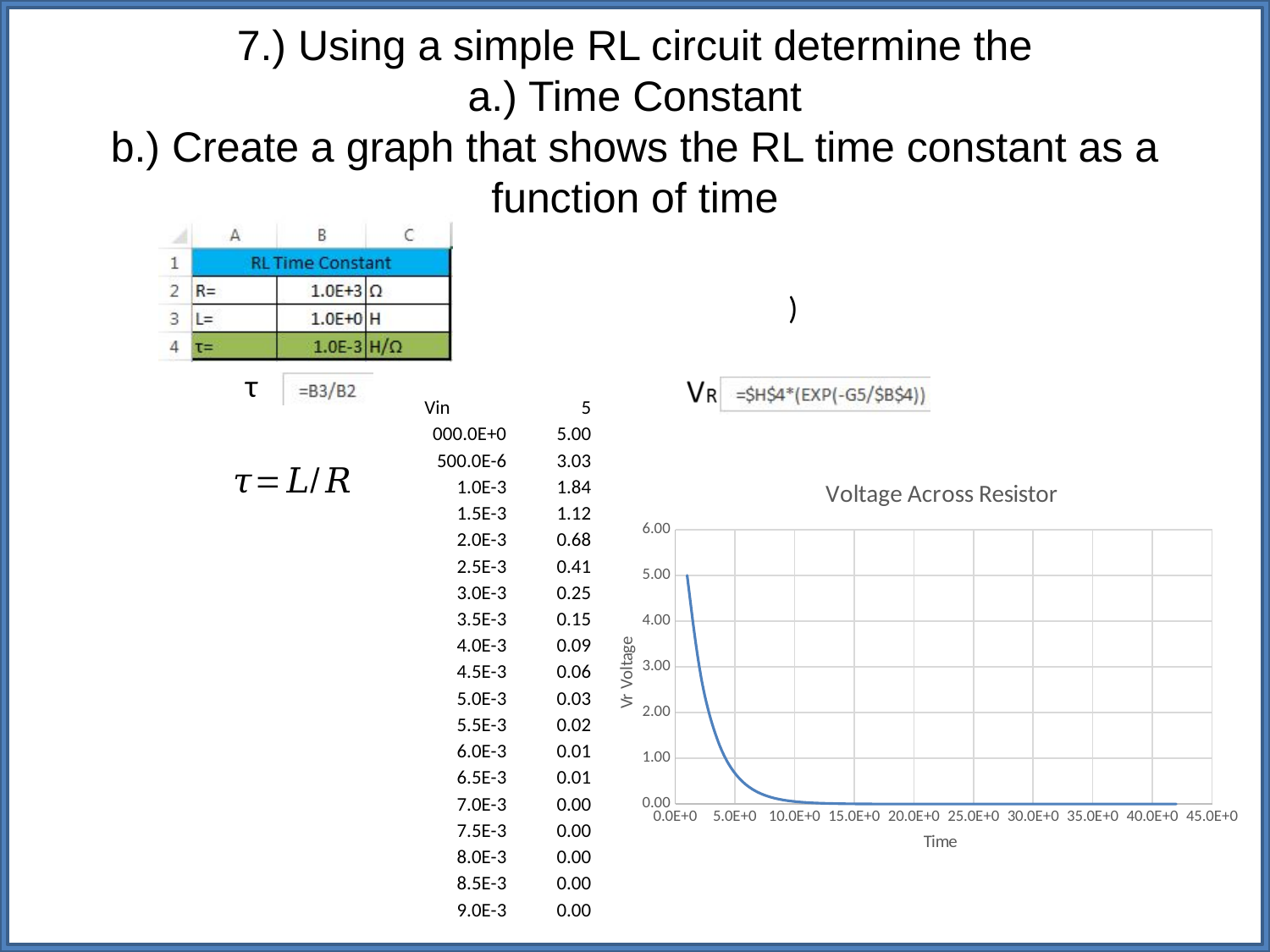
Is the value of the line at time 0.0E+0 greater or less than 4.00? greater At which time on the x axis does the line reach its highest value? 0.0E+0 What kind of chart is shown on the slide? line chart What is the title of the chart? Voltage Across Resistor What is the label on the vertical axis of the chart? Vr Voltage Do the values in the chart rise or fall as time increases along the x axis? fall Is the value of the line at time 5.0E+0 greater or less than 2.00? less Is the value of the line at time 30.0E+0 greater or less than 1.00? less What is the value of the line at the start of the chart, at time 0.0E+0? 5.00